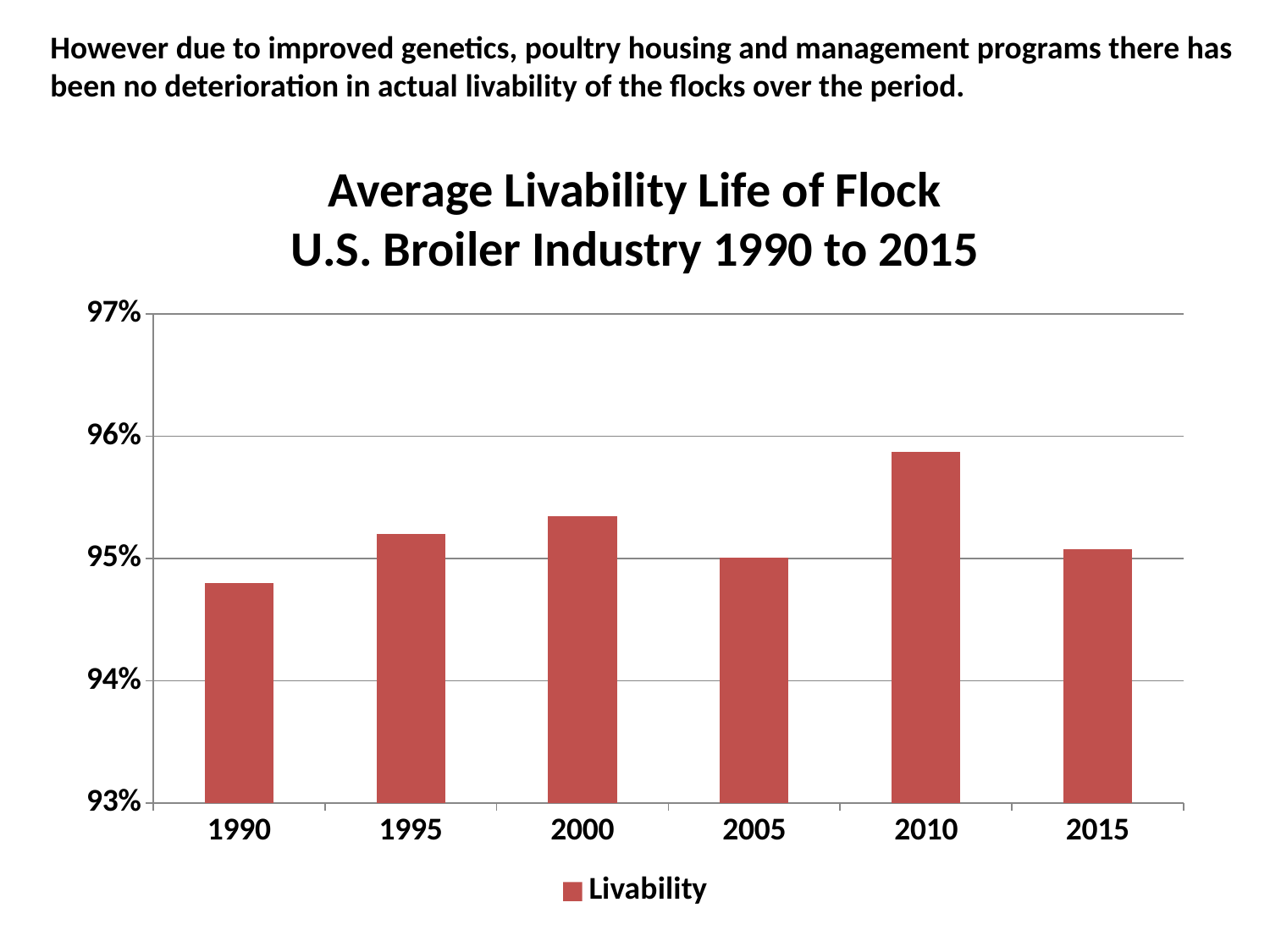
Is the livability value for 2010 greater or less than 96%? less Is the livability value for 1990 greater or less than 95%? less Which year has the lowest livability in the chart? 1990 Is the livability value for 1995 greater or less than 95%? greater How many years are shown on the x axis of the chart? 6 Which year has the higher livability, 2010 or 2015? 2010 Which year has the higher livability, 2000 or 2005? 2000 What is the name of the series listed in the chart's legend? Livability How many series does the chart's legend list? 1 Which year has the highest livability in the chart? 2010 What kind of chart is shown on the slide? bar chart